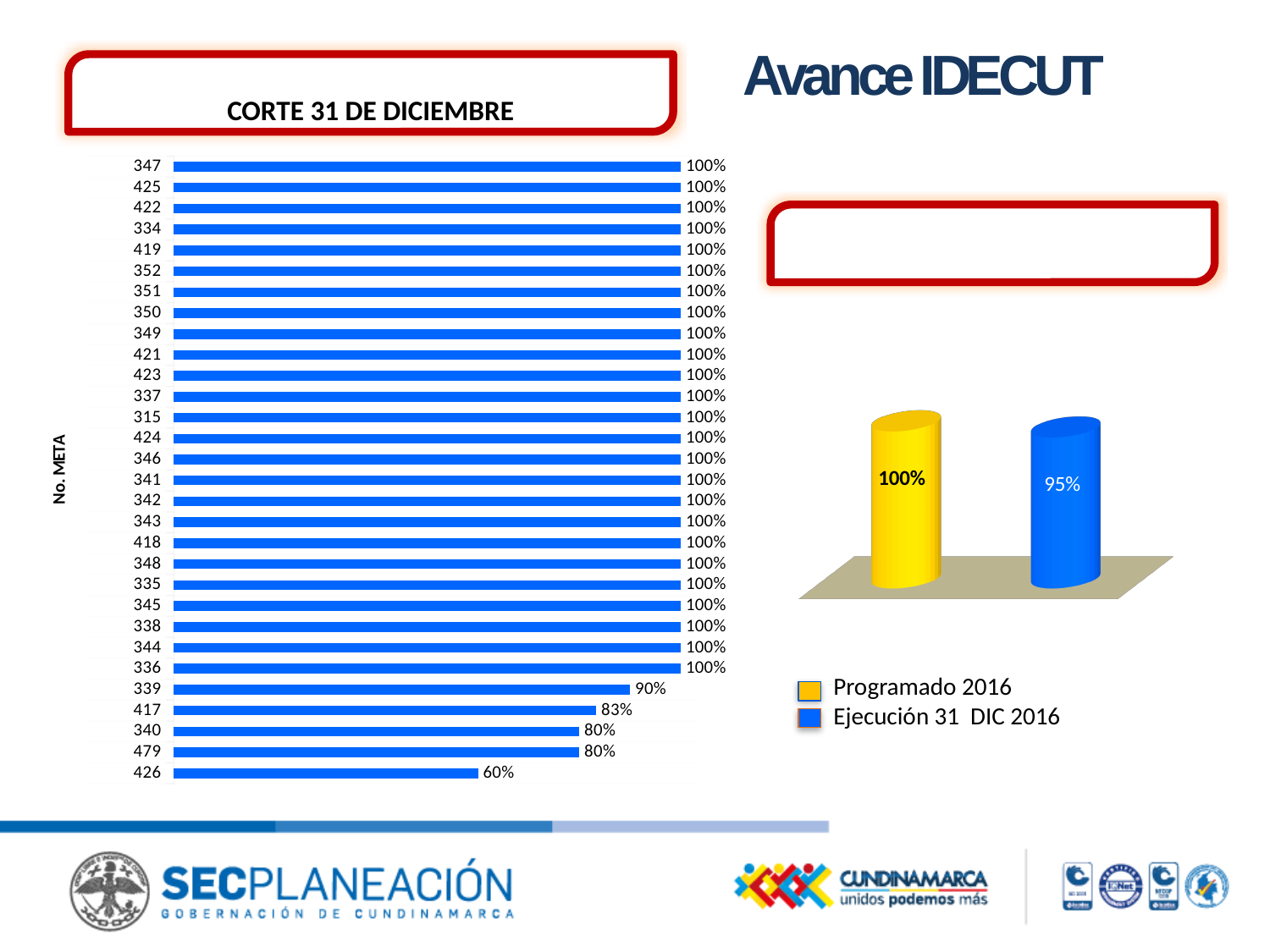
In the CORTE 31 DE DICIEMBRE bar chart, what is the value for META 417? 83% In the CORTE 31 DE DICIEMBRE bar chart, which has the larger value, META 340 or META 426? 340 In the CORTE 31 DE DICIEMBRE bar chart, which META has the lowest value? 426 In the chart on the right of the slide, what is the value for Ejecución 31 DIC 2016? 95% In the chart on the right of the slide, what is the value for Programado 2016? 100% What kind of chart is the CORTE 31 DE DICIEMBRE chart on the left of the slide? Bar chart In the CORTE 31 DE DICIEMBRE bar chart, what is the difference between the values for META 339 and META 426? 30% In the CORTE 31 DE DICIEMBRE bar chart, how many METAs have a value of 100%? 25 In the CORTE 31 DE DICIEMBRE bar chart, what is the value for META 426? 60% In the CORTE 31 DE DICIEMBRE bar chart, what is the value for META 339? 90% In the chart on the right of the slide, what is the difference between Programado 2016 and Ejecución 31 DIC 2016? 5% How many META categories are shown in the CORTE 31 DE DICIEMBRE bar chart? 30